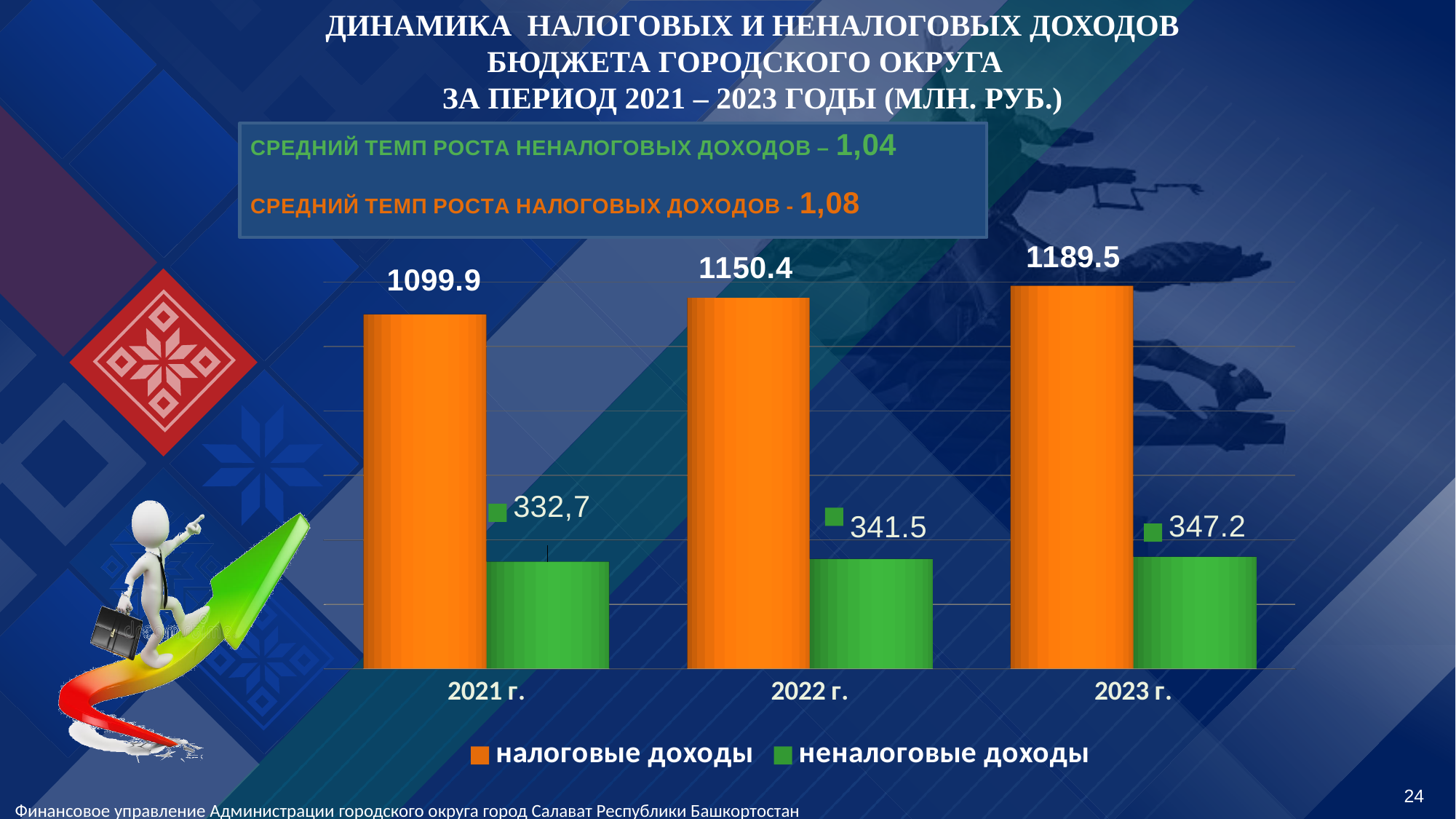
In which year are неналоговые доходы the lowest? 2021 г. Do налоговые доходы rise or fall from 2021 г. to 2023 г.? rise What is the difference between неналоговые доходы in 2023 г. and 2022 г.? 5.7 How many series does the legend list? 2 What is the value of неналоговые доходы for 2021 г.? 332,7 How many years are shown on the x axis of the chart? 3 By how much did налоговые доходы increase from 2021 г. to 2023 г.? 89.6 What is the value of налоговые доходы for 2021 г.? 1099.9 What is the value of неналоговые доходы for 2022 г.? 341.5 What is the value of налоговые доходы for 2023 г.? 1189.5 In which year are налоговые доходы the highest? 2023 г. Which is larger in 2022 г.: налоговые доходы or неналоговые доходы? налоговые доходы